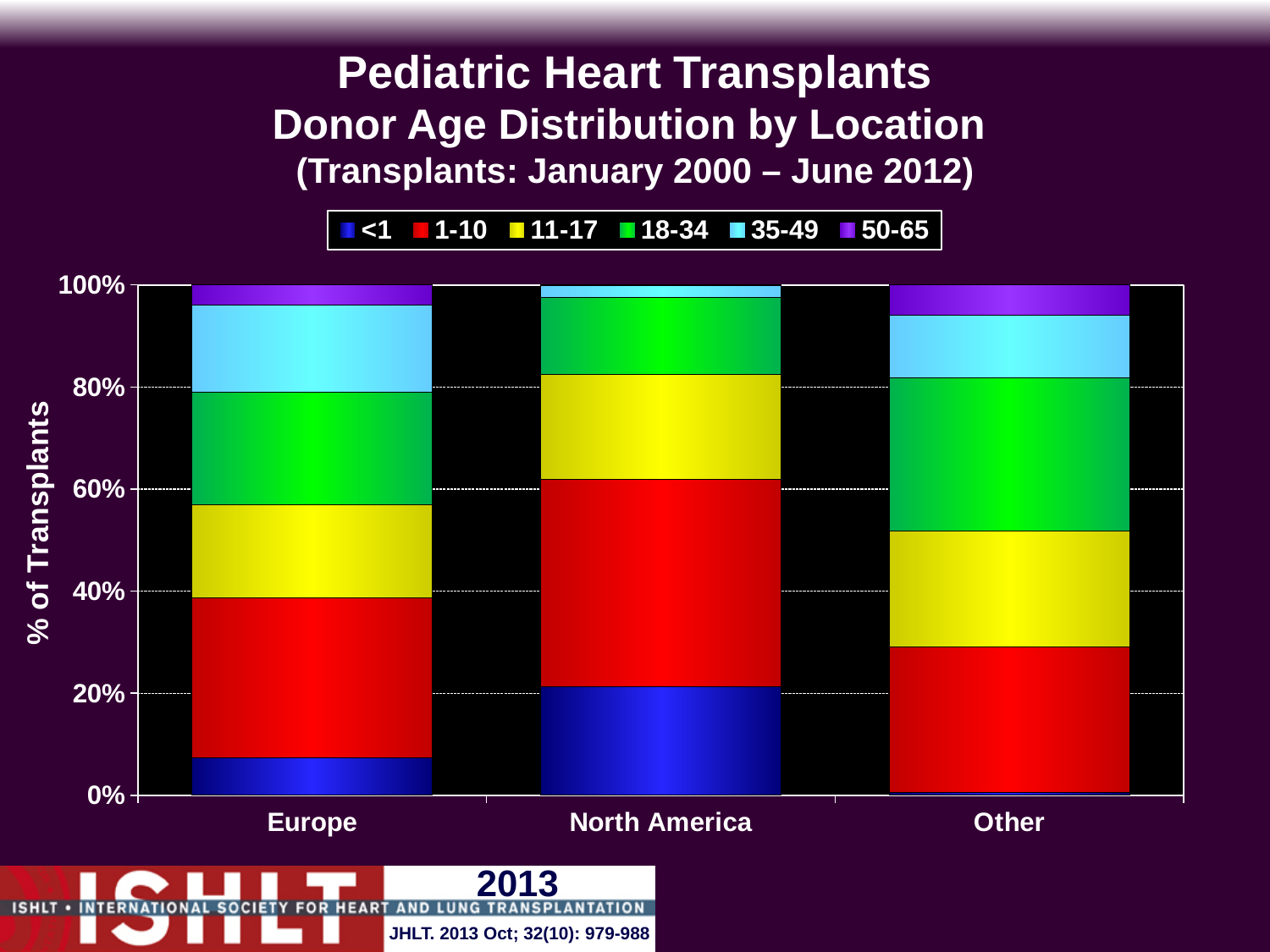
Is the share of donors aged 18-34 for North America greater or less than 20%? less Is the share of donors aged <1 for Europe greater or less than 20%? less Is the share of donors aged 18-34 larger for Other or for North America? Other How many locations are shown on the x axis of the chart? 3 How many donor age groups does the legend list? 6 Which location has the largest share of donors aged <1? North America What does each stacked bar total? 100% Which location has the smallest share of donors aged 35-49? North America Which donor age group is shown in red in the legend? 1-10 Is the share of donors aged 1-10 for Other greater or less than 20%? greater What is the label of the y axis? % of Transplants What kind of chart is shown on the slide? Stacked bar chart